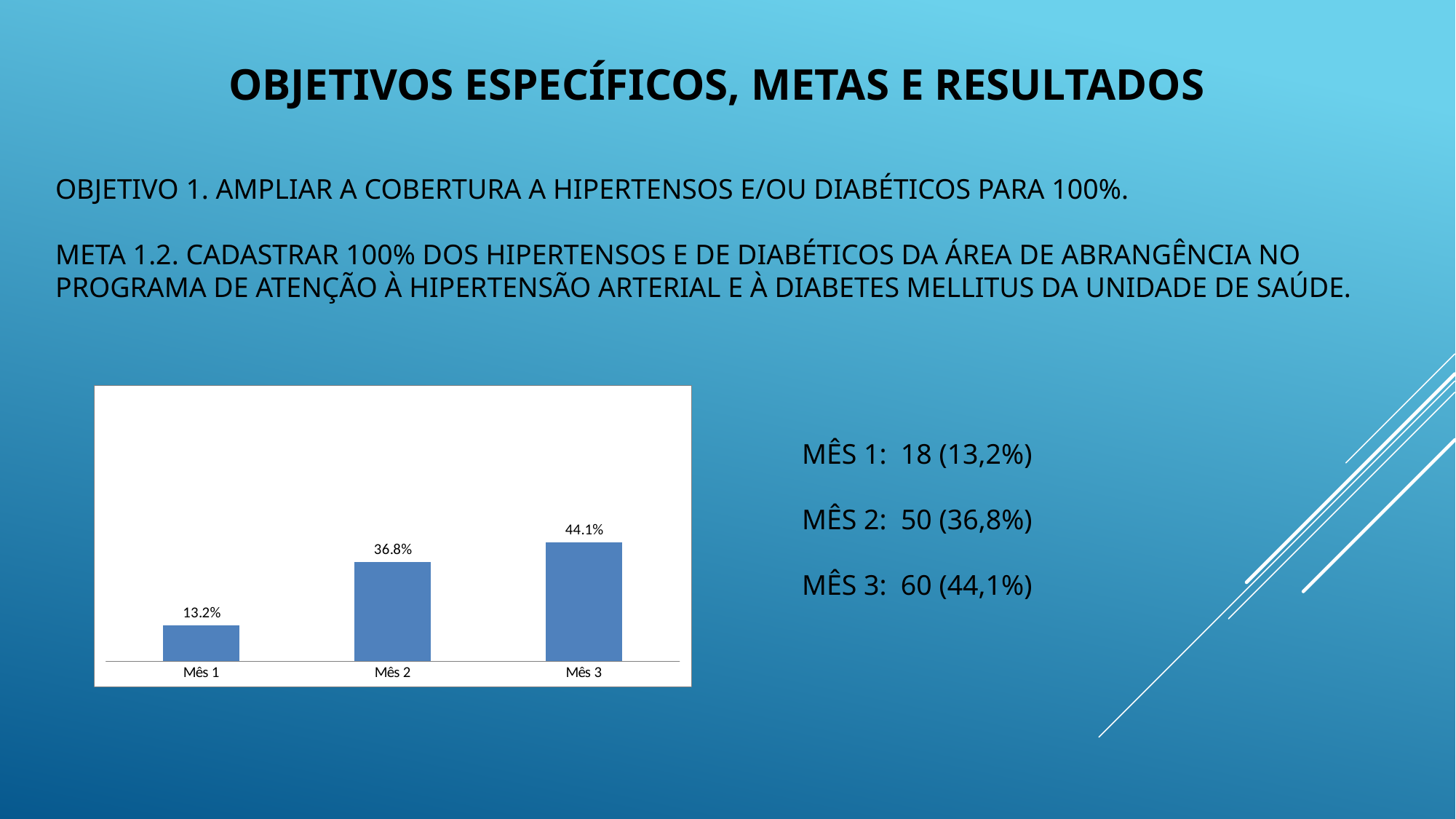
How many bars are plotted in the chart? 3 What kind of chart is shown on the slide? Bar chart Which is larger, the value for Mês 1 or the value for Mês 2? Mês 2 What is the difference between the values for Mês 3 and Mês 2? 7.3% Do the values rise or fall from Mês 1 to Mês 3? Rise What is the value shown for Mês 1? 13.2% Which month has the lowest value? Mês 1 What is the value shown for Mês 2? 36.8% What is the value shown for Mês 3? 44.1% Which month has the highest value? Mês 3 What is the difference between the values for Mês 2 and Mês 1? 23.6% What colour are the bars in the chart? Blue